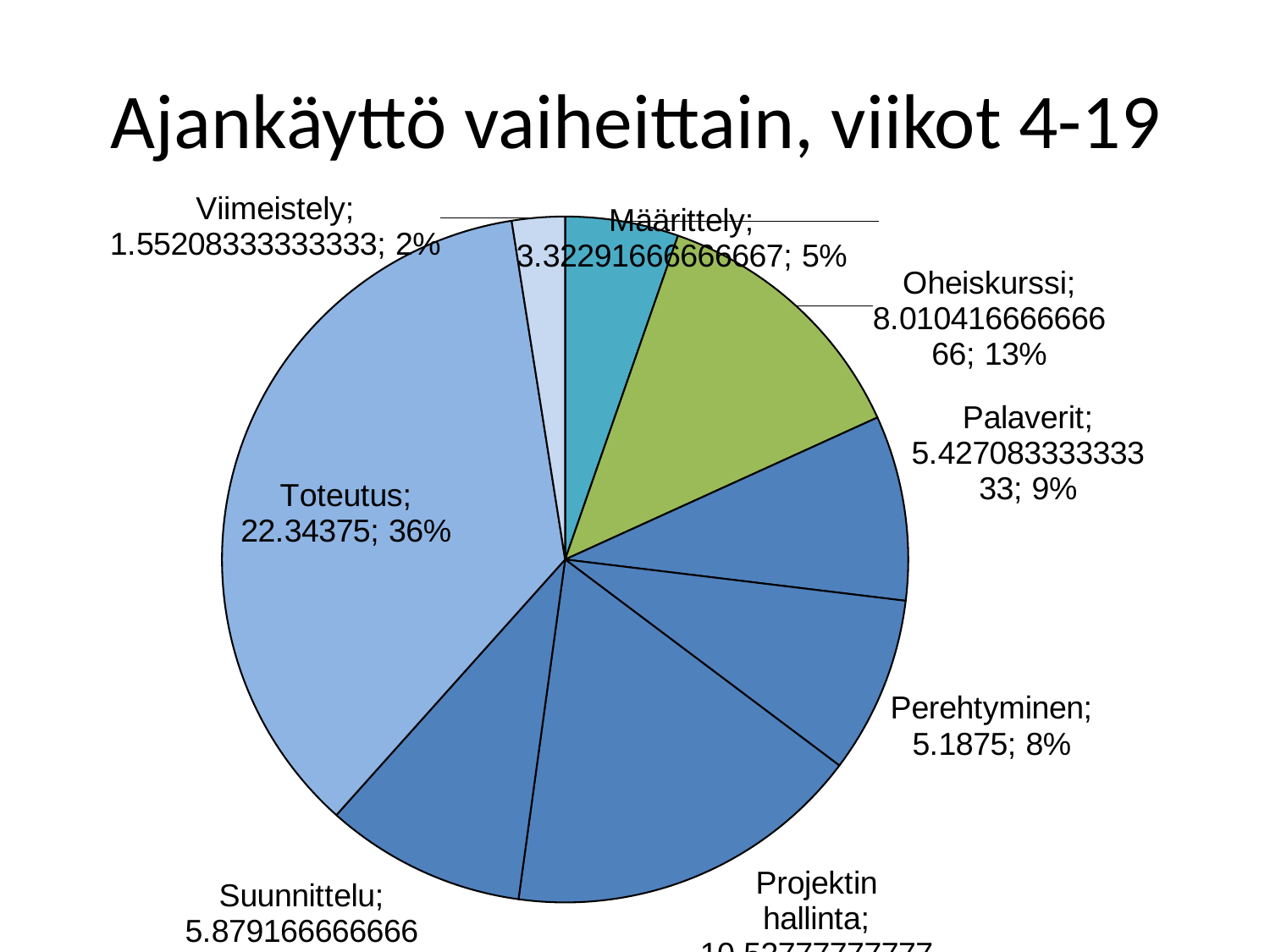
What type of chart is shown on the slide? pie chart What share of the pie does Toteutus represent? 36% Which category has the largest slice of the pie? Toteutus What is the value shown for Perehtyminen? 5.1875 What share of the pie does Viimeistely represent? 2% Which category has the smallest slice of the pie? Viimeistely What share of the pie does Määrittely represent? 5% By how many percentage points does the share of Toteutus exceed the share of Oheiskurssi? 23 Which is larger, the slice for Palaverit or the slice for Perehtyminen? Palaverit How many slices does the pie chart have? 8 What is the title of the chart? Ajankäyttö vaiheittain, viikot 4-19